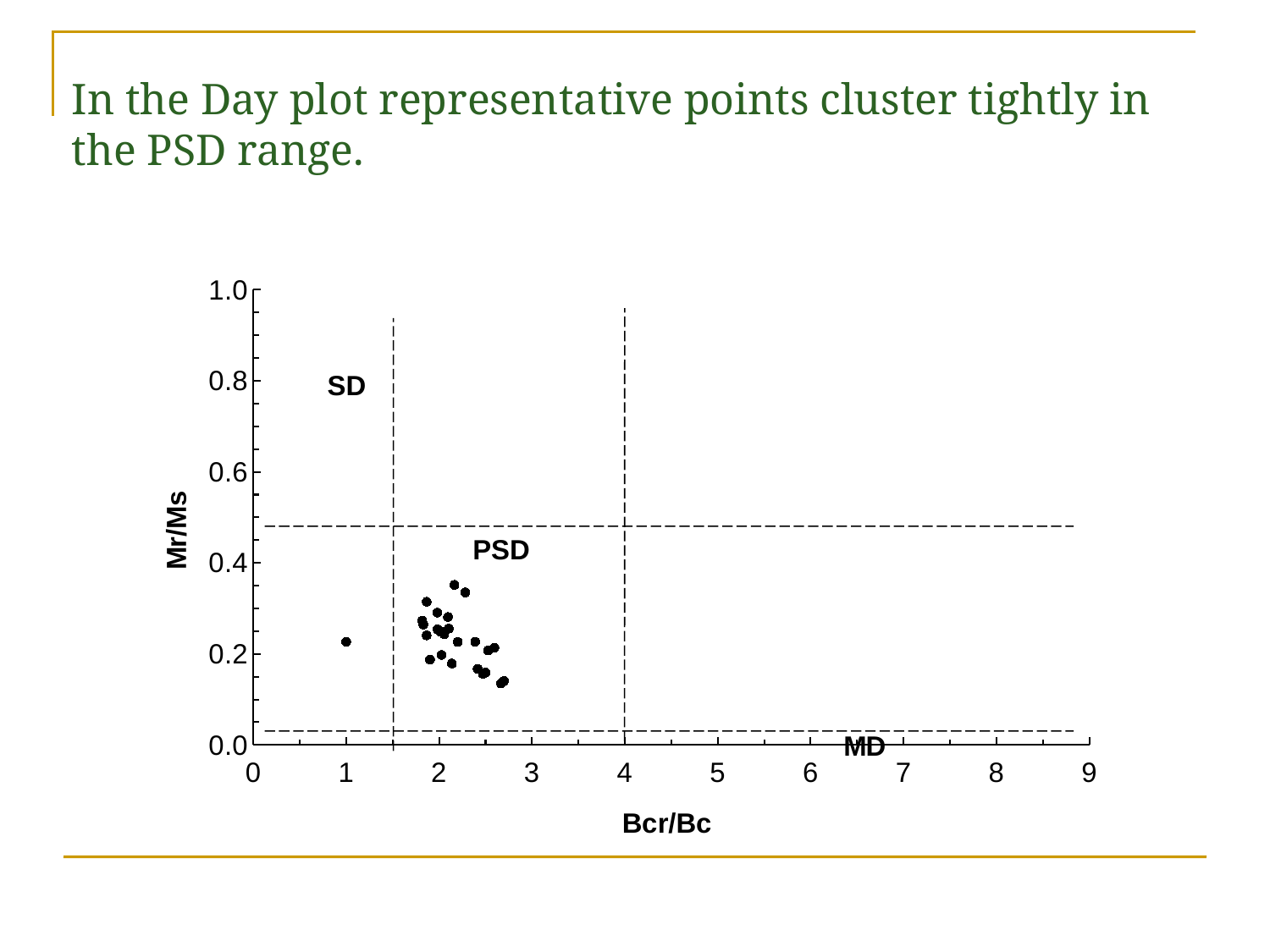
What is the maximum value shown on the x axis? 9 What kind of chart is shown on the slide? scatter plot What is the label on the y axis of the chart? Mr/Ms Are the Bcr/Bc values of the main cluster of points greater or less than 4? less Are there any plotted points in the MD region? No Is the highest Mr/Ms value among the plotted points greater or less than 0.4? less Is the lowest Mr/Ms value among the plotted points greater or less than 0.1? greater In which labelled region do most of the plotted points fall? PSD How many labelled regions (SD, PSD, MD) are marked on the chart? 3 What is the label on the x axis of the chart? Bcr/Bc